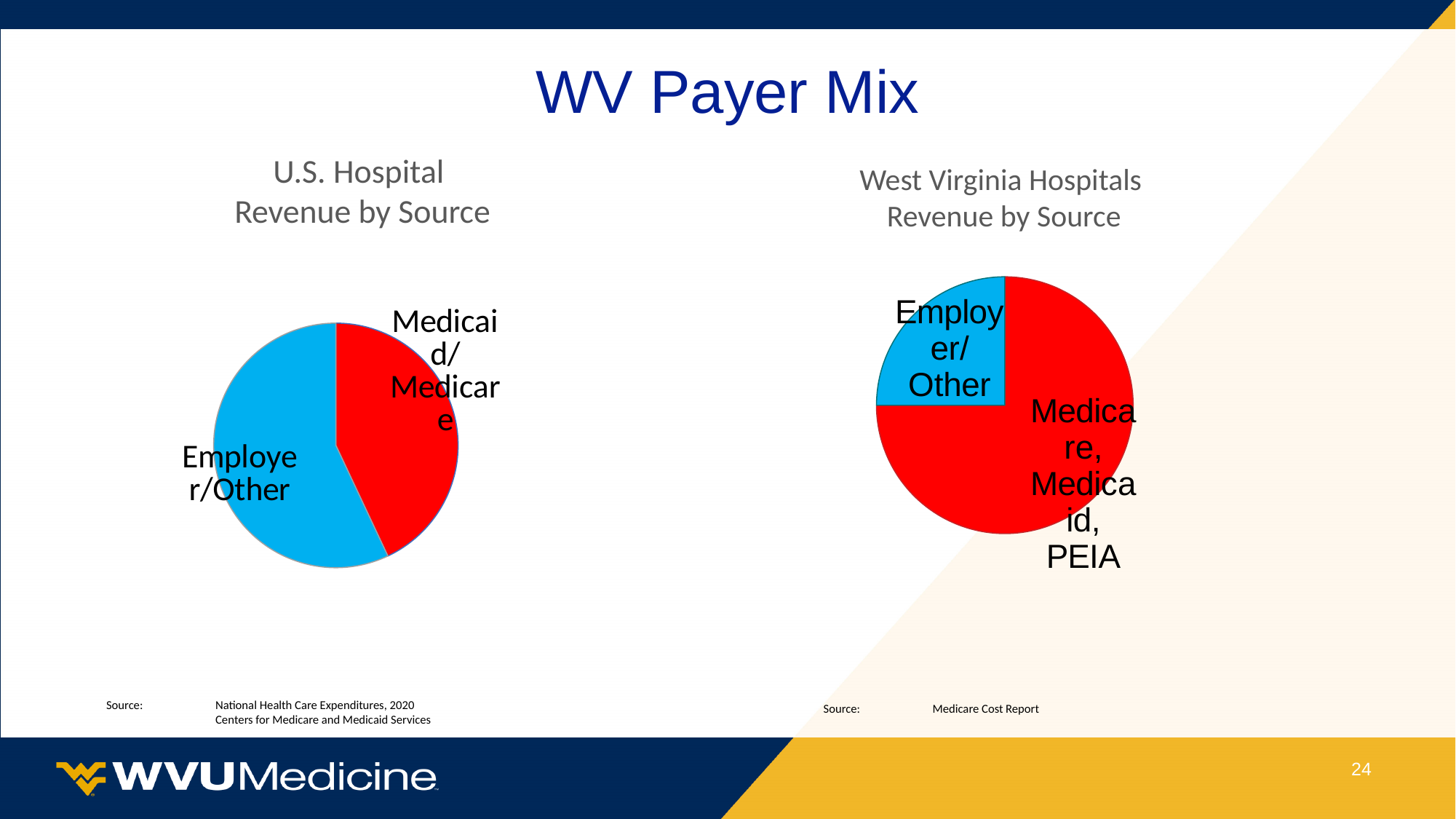
In the "West Virginia Hospitals Revenue by Source" chart, which is larger: Employer/Other or Medicare, Medicaid, PEIA? Medicare, Medicaid, PEIA How many slices does the "U.S. Hospital Revenue by Source" pie chart have? 2 What kind of chart is the "West Virginia Hospitals Revenue by Source" chart? Pie chart In the "U.S. Hospital Revenue by Source" chart, which slice is the smallest? Medicaid/Medicare How many slices does the "West Virginia Hospitals Revenue by Source" pie chart have? 2 In the "West Virginia Hospitals Revenue by Source" chart, which slice is the largest? Medicare, Medicaid, PEIA In the "U.S. Hospital Revenue by Source" chart, which is larger: Employer/Other or Medicaid/Medicare? Employer/Other What kind of chart is the "U.S. Hospital Revenue by Source" chart? Pie chart What colour is the Employer/Other slice in the "West Virginia Hospitals Revenue by Source" chart? Blue What is the title of the pie chart on the left side of the slide? U.S. Hospital Revenue by Source In the "West Virginia Hospitals Revenue by Source" chart, which slice is the smallest? Employer/Other In the "U.S. Hospital Revenue by Source" chart, which slice is the largest? Employer/Other